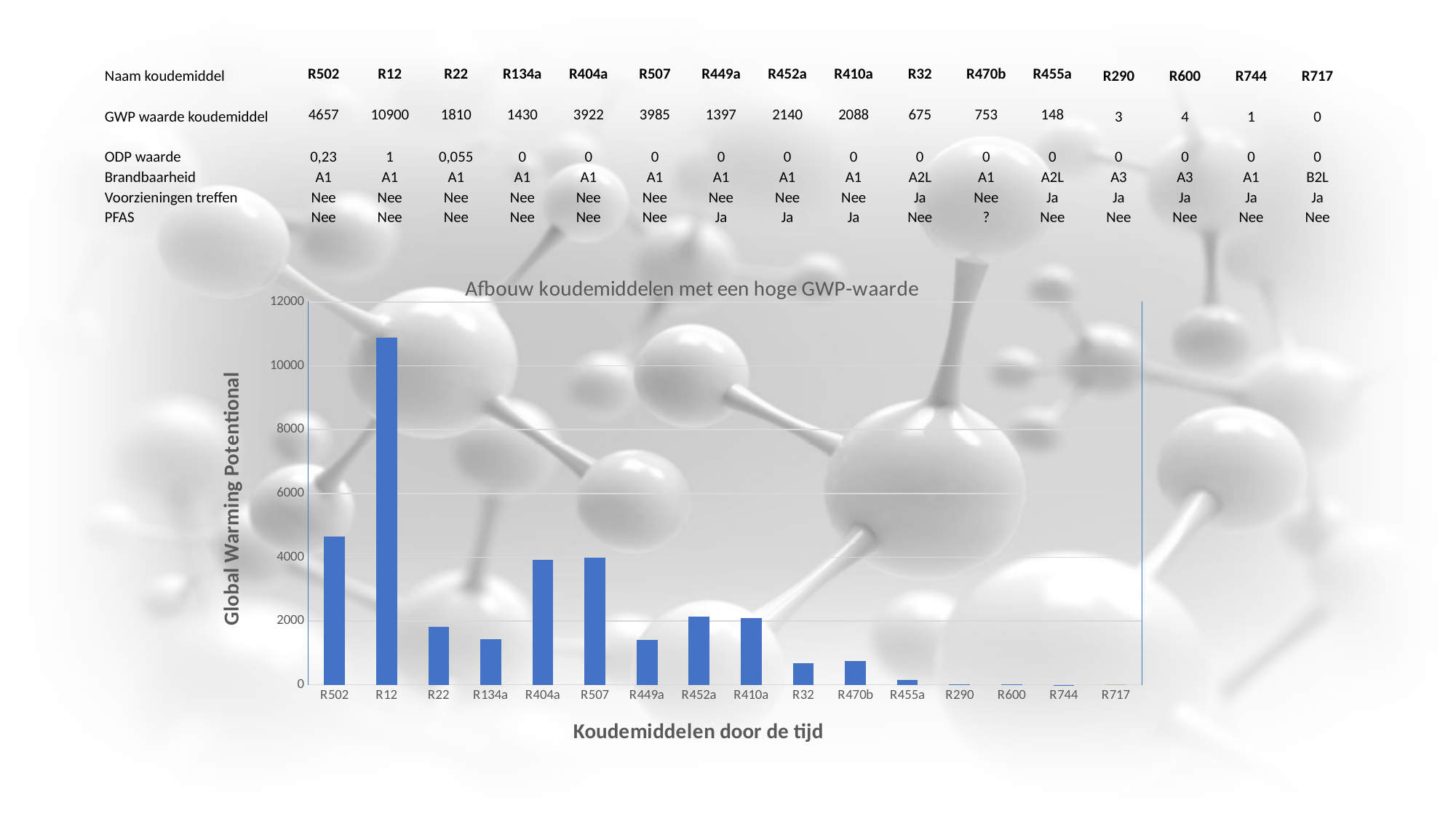
What is the GWP value for R404a according to the slide? 3922 Is the value for R22 greater or less than 2000? less What is the GWP value for R502 according to the slide? 4657 What is the title of the chart? Afbouw koudemiddelen met een hoge GWP-waarde Which refrigerant has the highest Global Warming Potential in the chart? R12 What is the label of the x axis of the chart? Koudemiddelen door de tijd Which has a higher Global Warming Potential, R452a or R449a? R452a Which refrigerant has the lowest Global Warming Potential in the chart? R717 Is the value for R12 greater or less than 10000? greater What is the difference between the GWP values of R12 and R502? 6243 How many refrigerants (categories) are plotted on the x axis of the chart? 16 What kind of chart is shown on the slide? bar chart